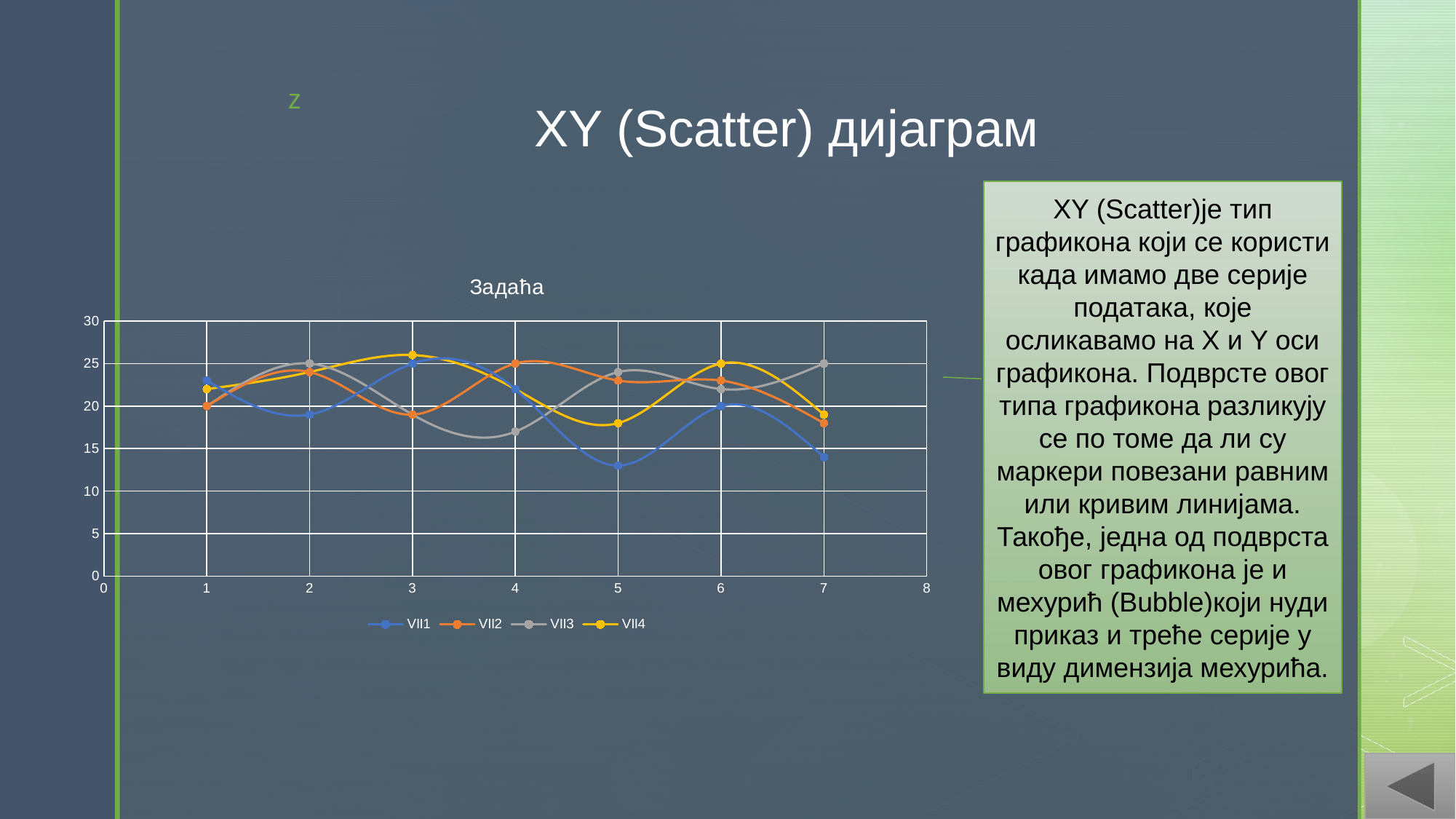
At x = 3, which series has the larger value, VII4 or VII2? VII4 Is the value for VII3 at x = 4 greater or less than 20? less At which x value does series VII1 reach its lowest point? 5 Which series are listed in the chart legend? VII1, VII2, VII3, VII4 How many series does the chart legend list? 4 What kind of chart is shown on the slide? XY scatter chart with smooth lines Is the value for VII3 at x = 7 greater or less than 20? greater What is the title of the chart on the slide? Задаћа At x = 5, which series has the larger value, VII1 or VII2? VII2 How many data points does each series have in the chart? 7 Is the value for VII1 at x = 5 greater or less than 15? less